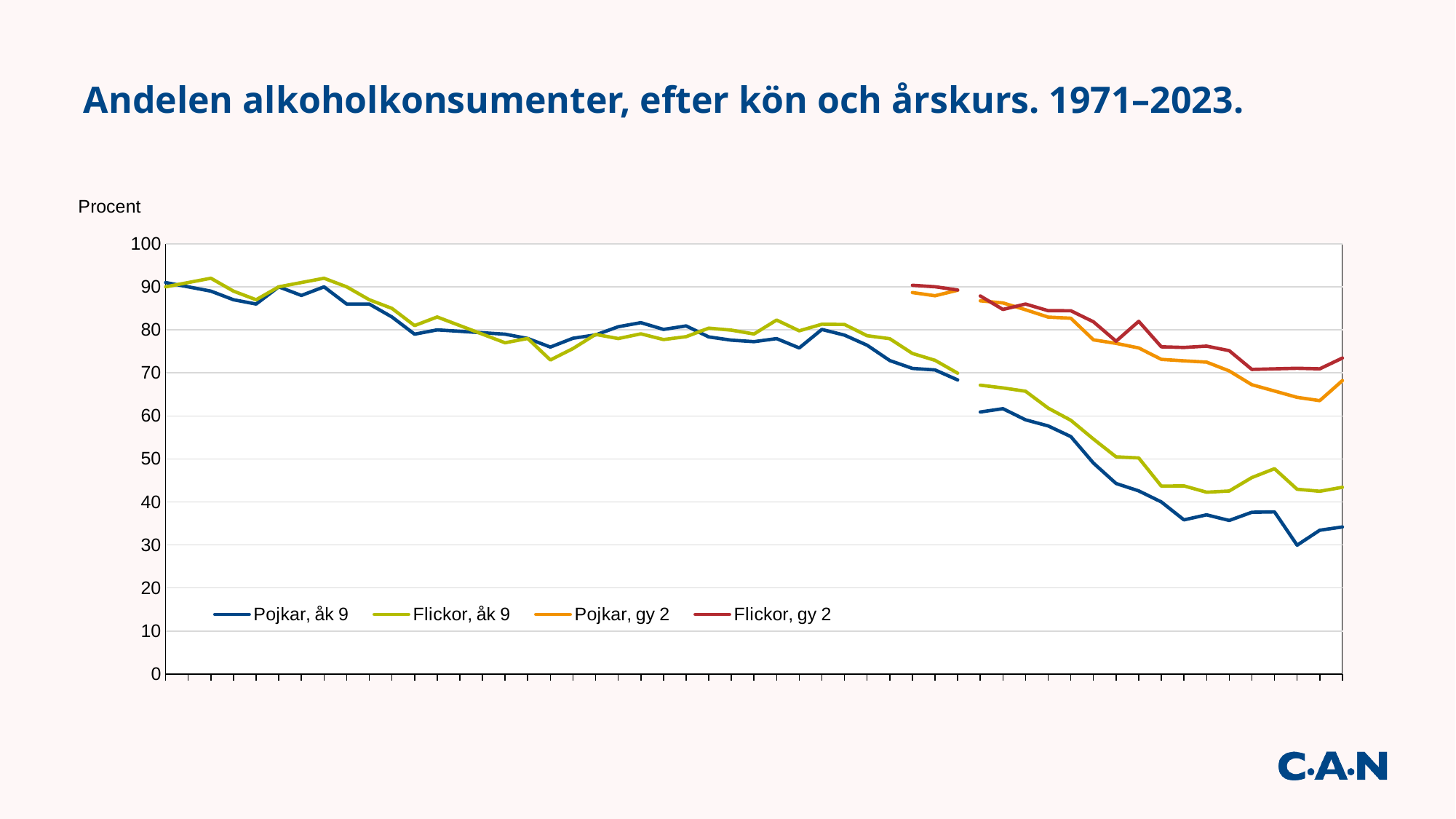
Is the final (2023) value for Flickor, åk 9 greater or less than 50? less What is the label on the vertical axis of the chart? Procent At the right end of the chart (2023), which series has the highest value? Flickor, gy 2 Does the Flickor, gy 2 line rise or fall overall from left to right? fall At the right end of the chart (2023), which series has the lowest value? Pojkar, åk 9 Is the final (2023) value for Pojkar, gy 2 greater or less than 60? greater Is the final (2023) value for Flickor, gy 2 greater or less than 80? less How many series does the legend list? 4 Does the Pojkar, åk 9 line rise or fall overall from left to right? fall What are the four series named in the legend? Pojkar, åk 9; Flickor, åk 9; Pojkar, gy 2; Flickor, gy 2 What kind of chart is shown on the slide? line chart